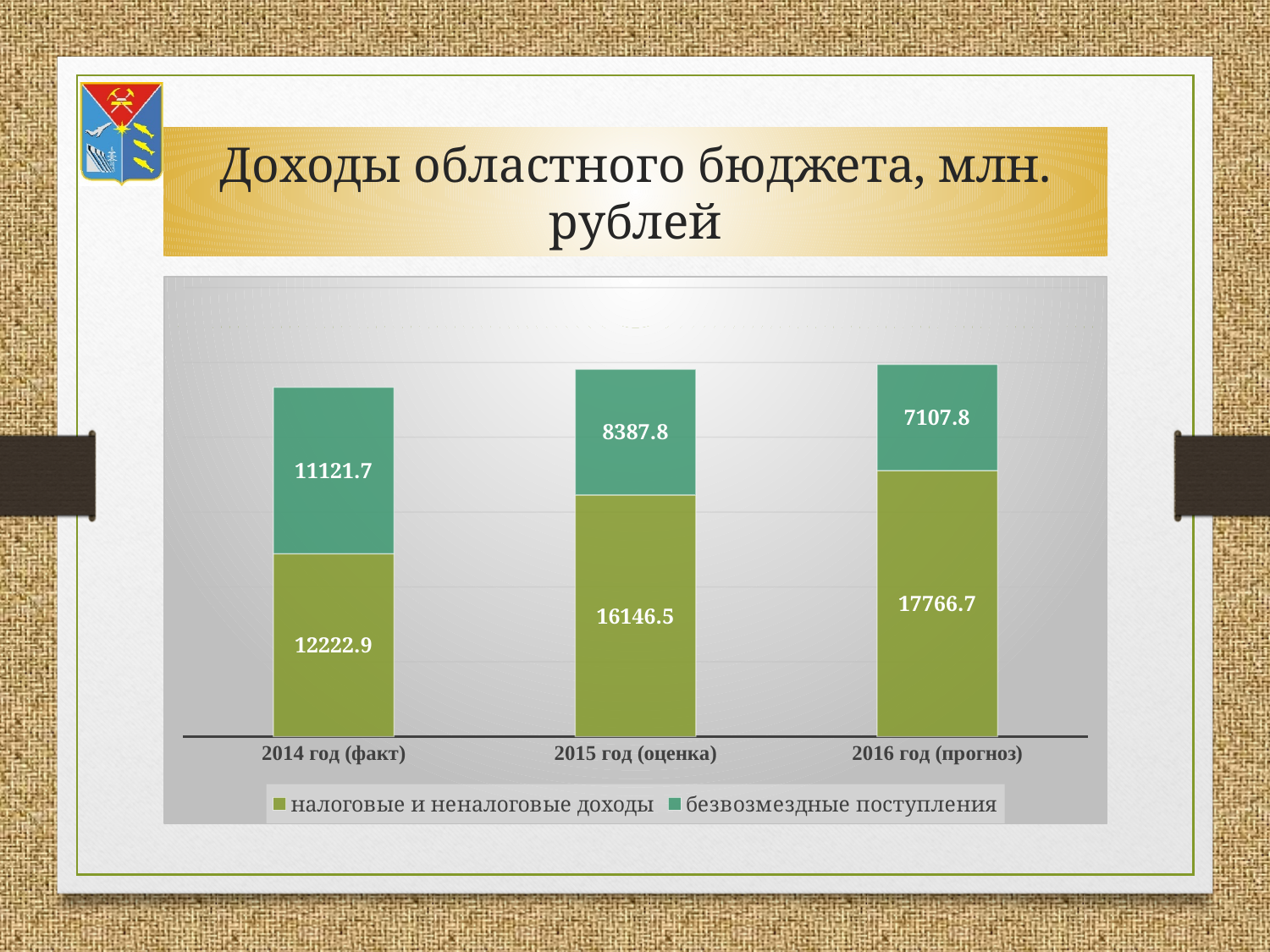
What is the value of налоговые и неналоговые доходы for 2014 год (факт)? 12222.9 How many years are shown on the x axis? 3 How many series does the legend list? 2 Which year has the lowest value for безвозмездные поступления? 2016 год (прогноз) What kind of chart is shown on the slide? stacked bar chart Which is larger in 2014 год (факт): налоговые и неналоговые доходы or безвозмездные поступления? налоговые и неналоговые доходы Do the values for безвозмездные поступления rise or fall from 2014 to 2016? fall What is the value of безвозмездные поступления for 2016 год (прогноз)? 7107.8 What is the value of безвозмездные поступления for 2015 год (оценка)? 8387.8 Which year has the highest value for налоговые и неналоговые доходы? 2016 год (прогноз) What is the total of the stacked bar for 2015 год (оценка)? 24534.3 What is the difference between налоговые и неналоговые доходы in 2016 год (прогноз) and in 2014 год (факт)? 5543.8